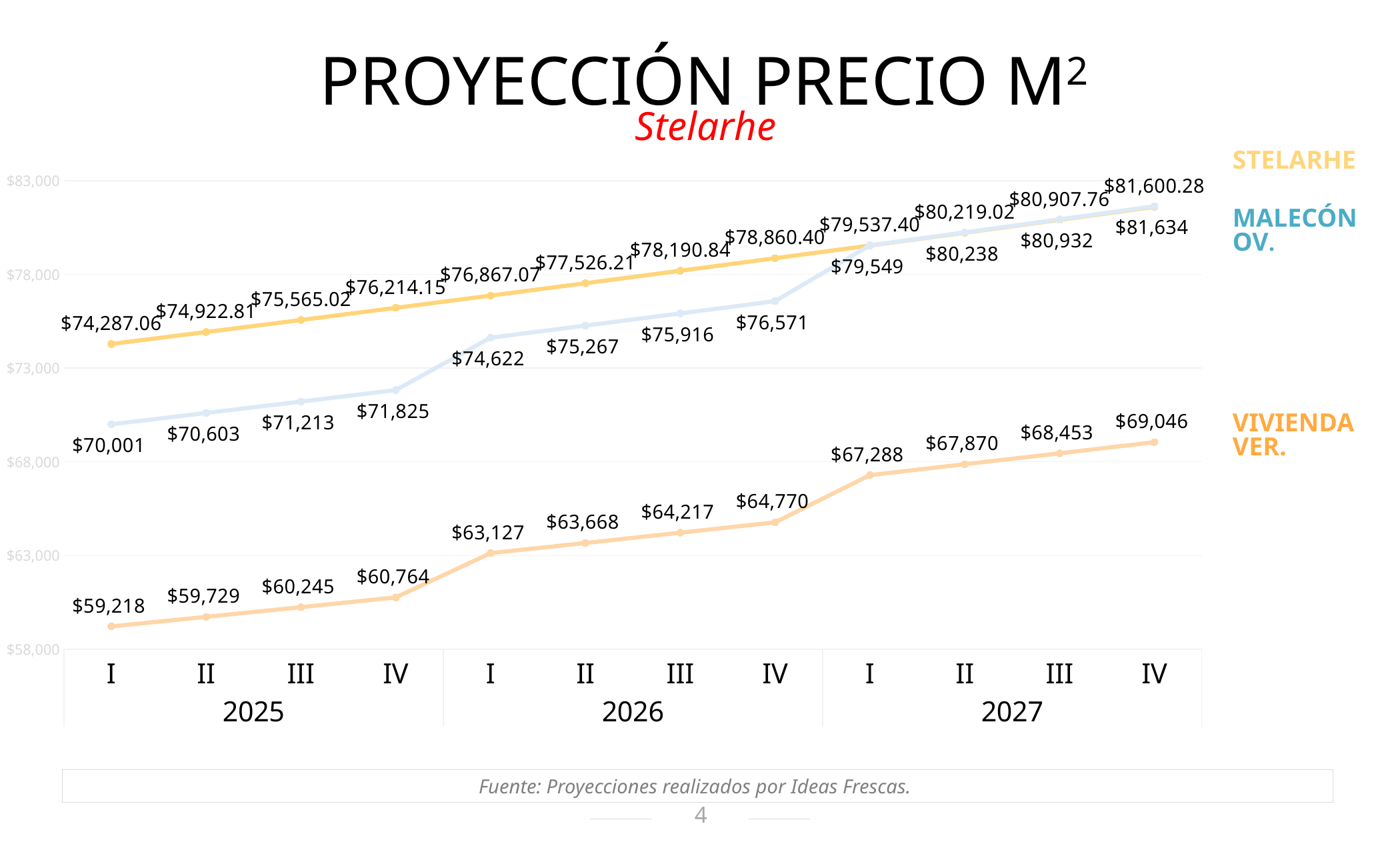
What type of chart is shown on the slide? line chart Which series has the lowest value in quarter IV of 2027? VIVIENDA VER. Which series has the highest value in quarter I of 2025? STELARHE Which is larger in quarter II of 2026: the STELARHE value or the MALECÓN OV. value? STELARHE What is the source cited below the chart? Proyecciones realizados por Ideas Frescas. How many quarterly points are plotted along the x axis? 12 What is the difference between the VIVIENDA VER. values for quarter IV of 2027 and quarter I of 2025? $9,828 What is the MALECÓN OV. value for quarter IV of 2027? $81,634 How many series does the chart show? 3 What is the STELARHE value for quarter I of 2025? $74,287.06 Do the VIVIENDA VER. values rise or fall from 2025 to 2027? rise What is the VIVIENDA VER. value for quarter I of 2026? $63,127